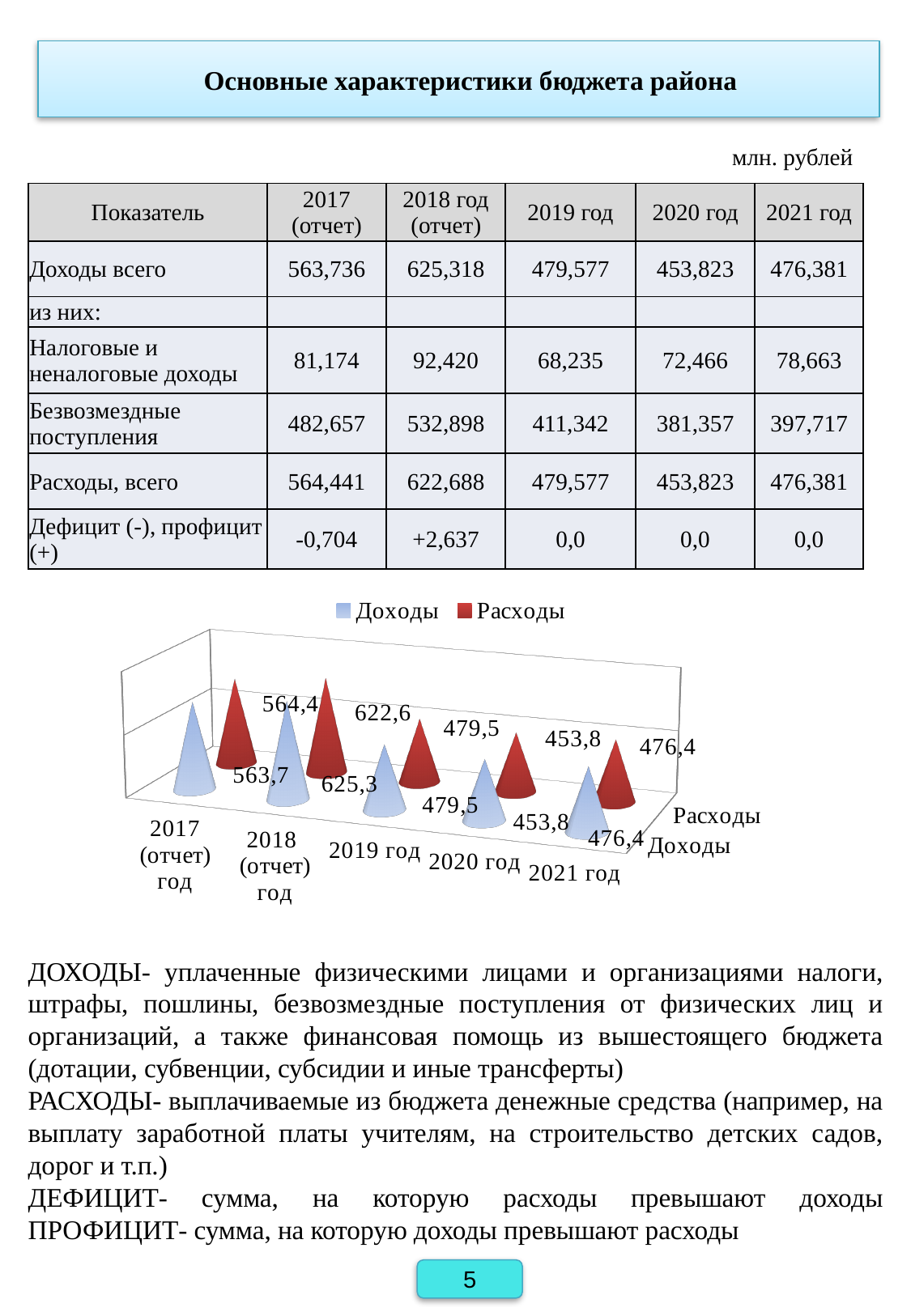
How many years (categories) are shown on the chart's x axis? 5 What is the value of Расходы for 2017 (отчет) год in the chart? 564,4 What is the value of Доходы for 2018 (отчет) год in the chart? 625,3 What is the difference between Доходы in 2018 (отчет) год and Доходы in 2017 (отчет) год? 61,6 What is the difference between Расходы in 2018 (отчет) год and Расходы in 2019 год? 143,1 What is the value of Расходы for 2021 год in the chart? 476,4 Do the Доходы values rise or fall from 2018 (отчет) год to 2020 год? fall In which year is Доходы highest in the chart? 2018 (отчет) год What kind of chart is shown on the slide? bar chart In which year is Расходы lowest in the chart? 2020 год Which is larger in 2017 (отчет) год: Доходы or Расходы? Расходы How many series does the chart legend list? 2